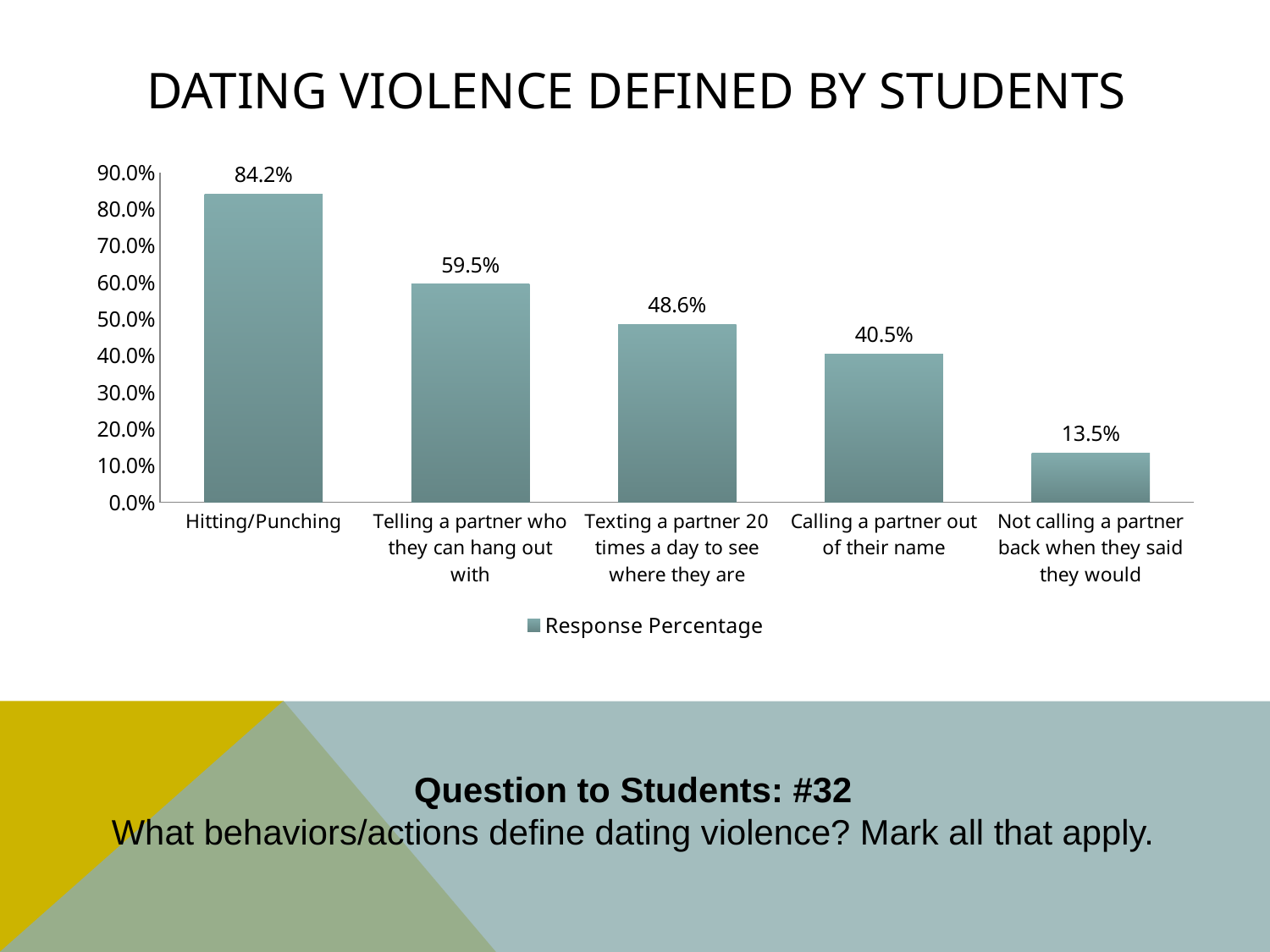
What kind of chart is shown on the slide? bar chart Which has a higher response percentage: Calling a partner out of their name or Texting a partner 20 times a day to see where they are? Texting a partner 20 times a day to see where they are Do the response percentages rise or fall from left to right across the categories? fall Which behavior has the highest response percentage? Hitting/Punching What is the difference in response percentage between Hitting/Punching and Telling a partner who they can hang out with? 24.7% What is the response percentage for Texting a partner 20 times a day to see where they are? 48.6% What is the response percentage for Not calling a partner back when they said they would? 13.5% How many behaviors are shown on the chart? 5 How many series does the legend list? 1 Is the response percentage for Calling a partner out of their name greater or less than 50.0%? less Which behavior has the lowest response percentage? Not calling a partner back when they said they would What is the response percentage for Hitting/Punching? 84.2%